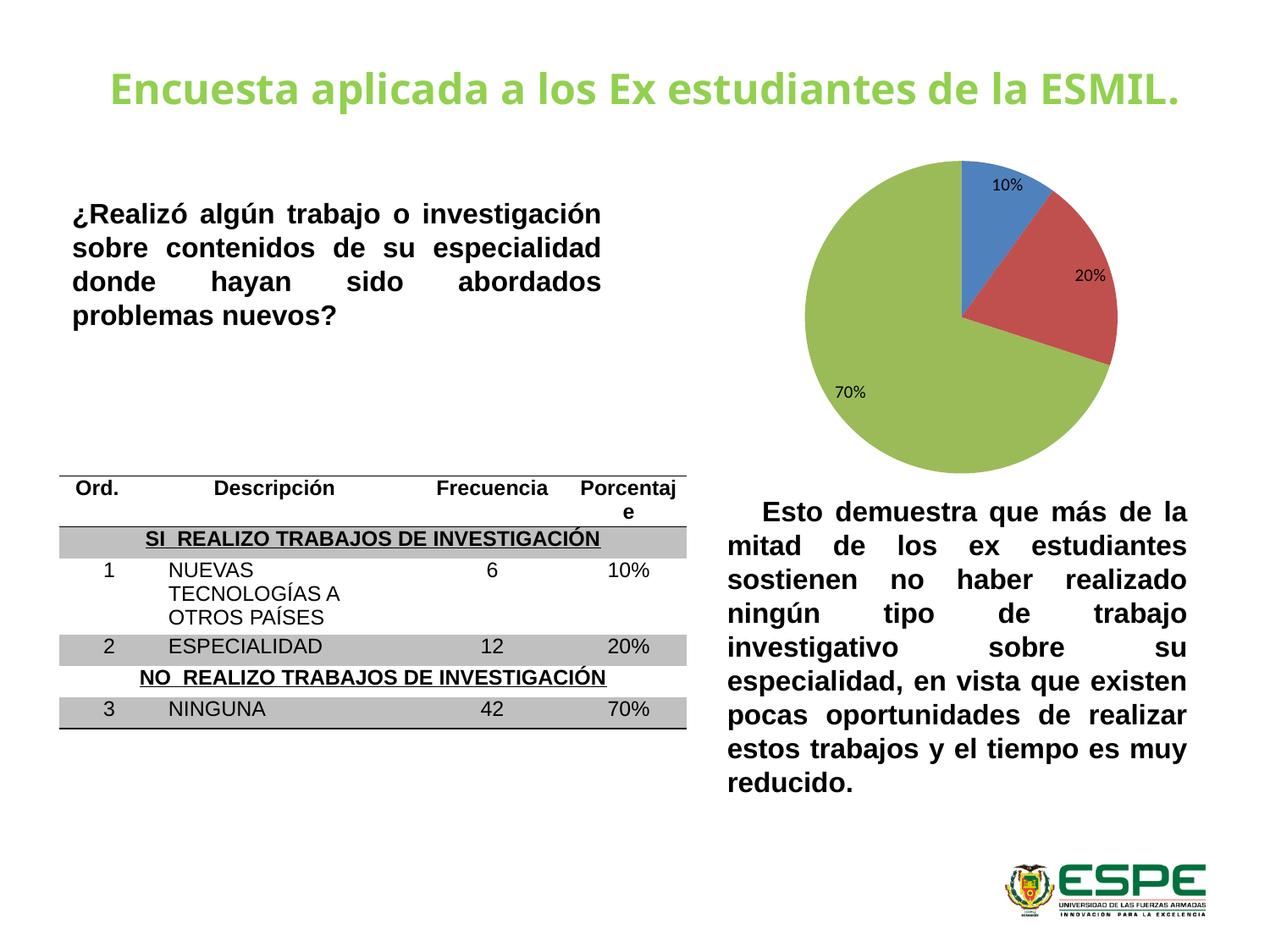
What is the smallest share shown in the pie chart? 10% What colour is the largest slice of the pie chart? green What percentage is shown on the green slice of the pie chart? 70% How many slices does the pie chart have? 3 What is the difference between the red slice and the blue slice of the pie chart? 10% What is the largest share shown in the pie chart? 70% Is the share of the green slice in the pie chart greater or less than 50%? greater What percentage is shown on the blue slice of the pie chart? 10% Which slice is larger in the pie chart, the red one or the blue one? the red one What is the difference between the largest and smallest slices of the pie chart? 60% What percentage is shown on the red slice of the pie chart? 20% What kind of chart is shown on the slide? pie chart